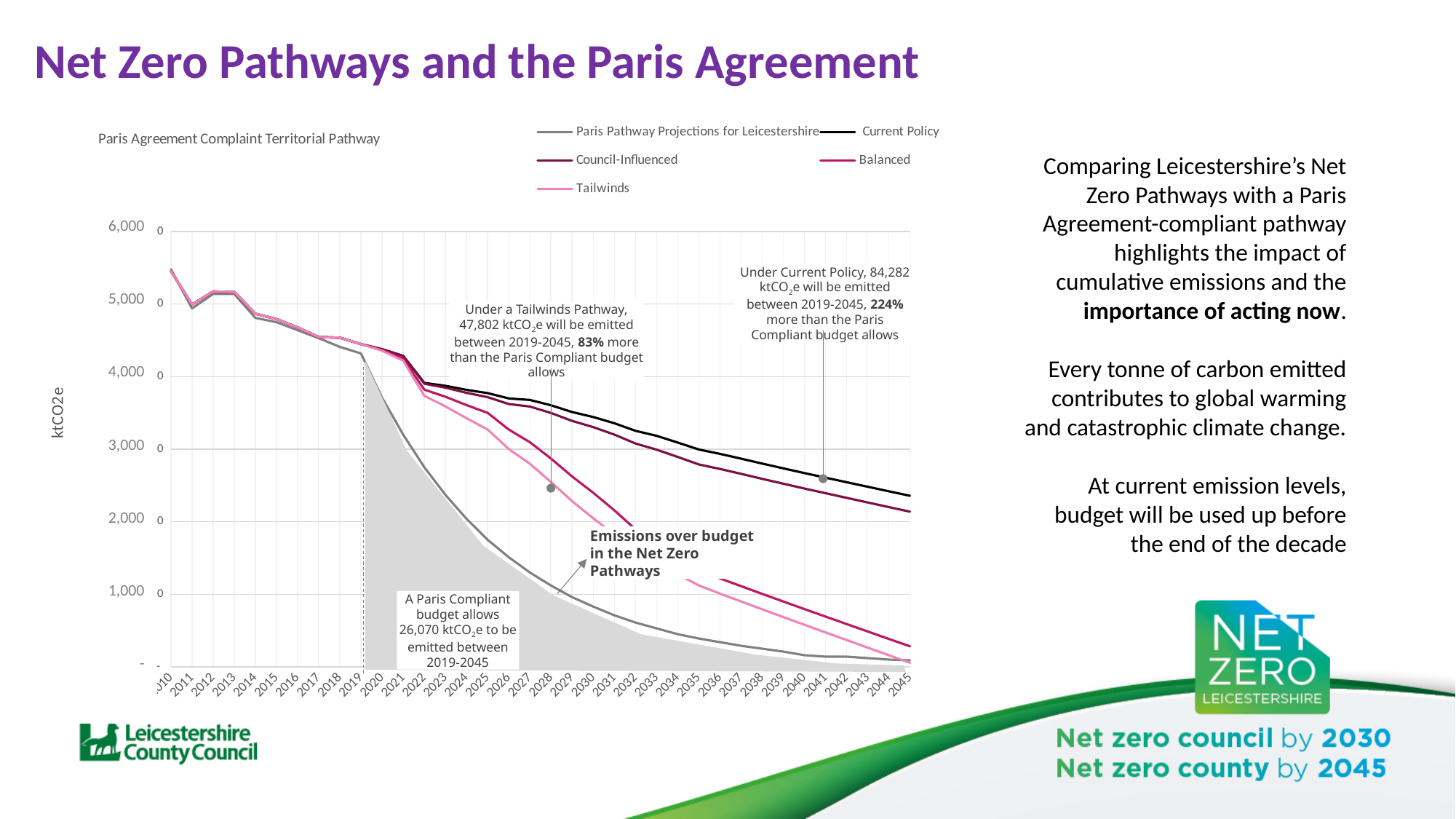
How many series does the chart legend list? 5 Is the Paris Pathway Projections for Leicestershire value in 2045 greater or less than 1,000? less What kind of chart is shown on the slide? line chart Is the Current Policy value in 2045 greater or less than 2,000? greater What is the title of the chart? Paris Agreement Complaint Territorial Pathway According to the chart annotation, how much does a Paris Compliant budget allow to be emitted between 2019-2045? 26,070 ktCO2e Which series has the highest value in 2045? Current Policy By what percentage do Current Policy emissions exceed the Paris Compliant budget, according to the chart annotation? 224% What unit is shown on the chart's vertical axis? ktCO2e Does the Paris Pathway Projections for Leicestershire series rise or fall from 2019 to 2045? fall According to the chart annotation, how much will be emitted between 2019-2045 under a Tailwinds Pathway? 47,802 ktCO2e According to the chart annotation, how much will be emitted between 2019-2045 under Current Policy? 84,282 ktCO2e